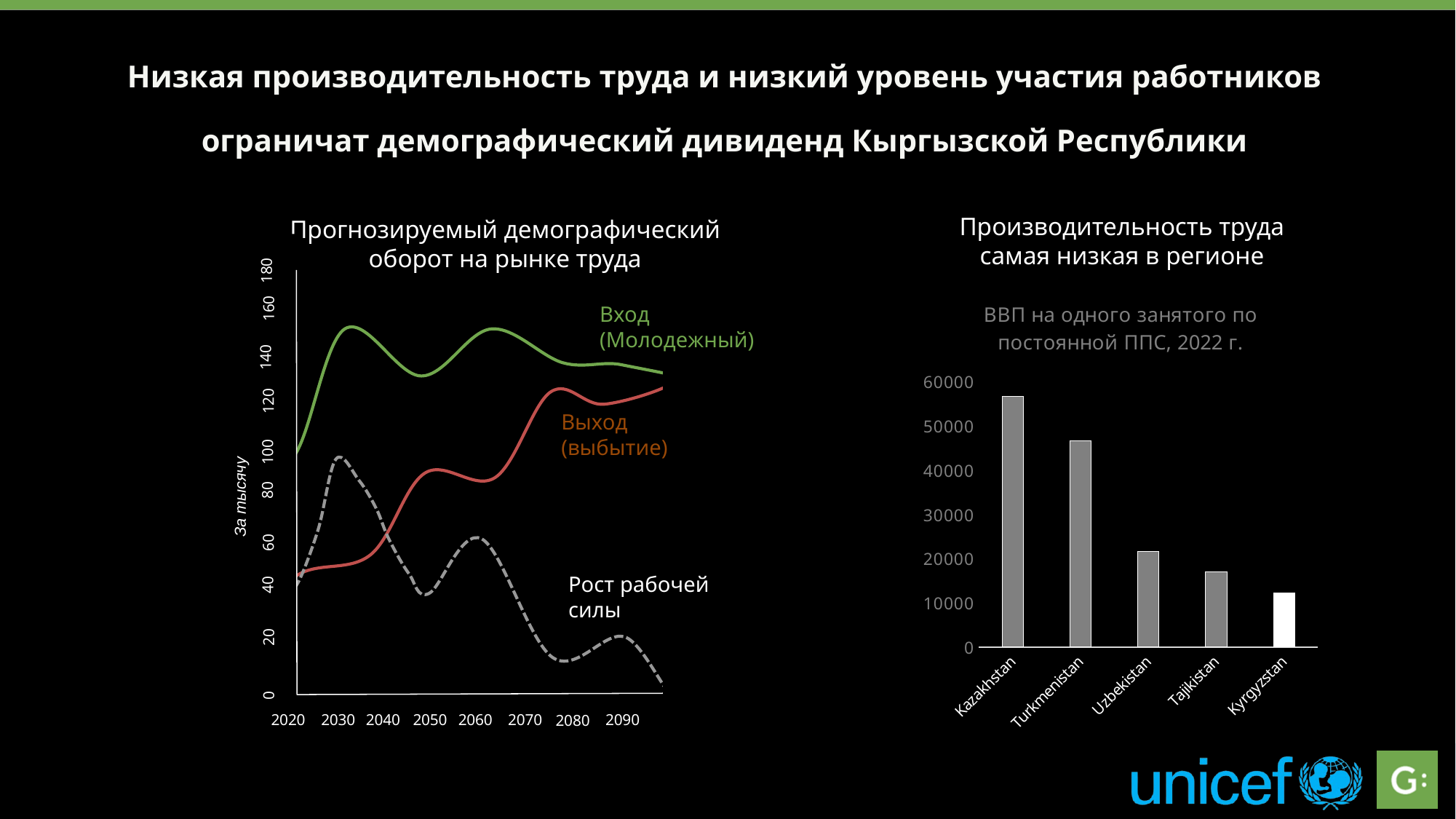
What kind of chart is the chart on the left (Прогнозируемый демографический оборот на рынке труда)? line chart In the bar chart on the right, is the value for Turkmenistan greater or less than 40000? greater In the chart on the left, does the Рост рабочей силы line rise or fall between 2060 and 2080? fall How many series (lines) are plotted in the chart on the left? 3 In the bar chart on the right, which is larger, the value for Uzbekistan or the value for Tajikistan? Uzbekistan In the bar chart on the right, is the value for Kazakhstan greater or less than 50000? greater What kind of chart is the chart on the right? bar chart In the chart on the left, which series is higher in 2050, Вход (Молодежный) or Выход (выбытие)? Вход (Молодежный) How many countries are shown in the bar chart on the right? 5 In the bar chart on the right, which country has the lowest value? Kyrgyzstan In the bar chart on the right (Производительность труда самая низкая в регионе), which country has the highest value? Kazakhstan In the bar chart on the right, is the value for Kyrgyzstan greater or less than 20000? less